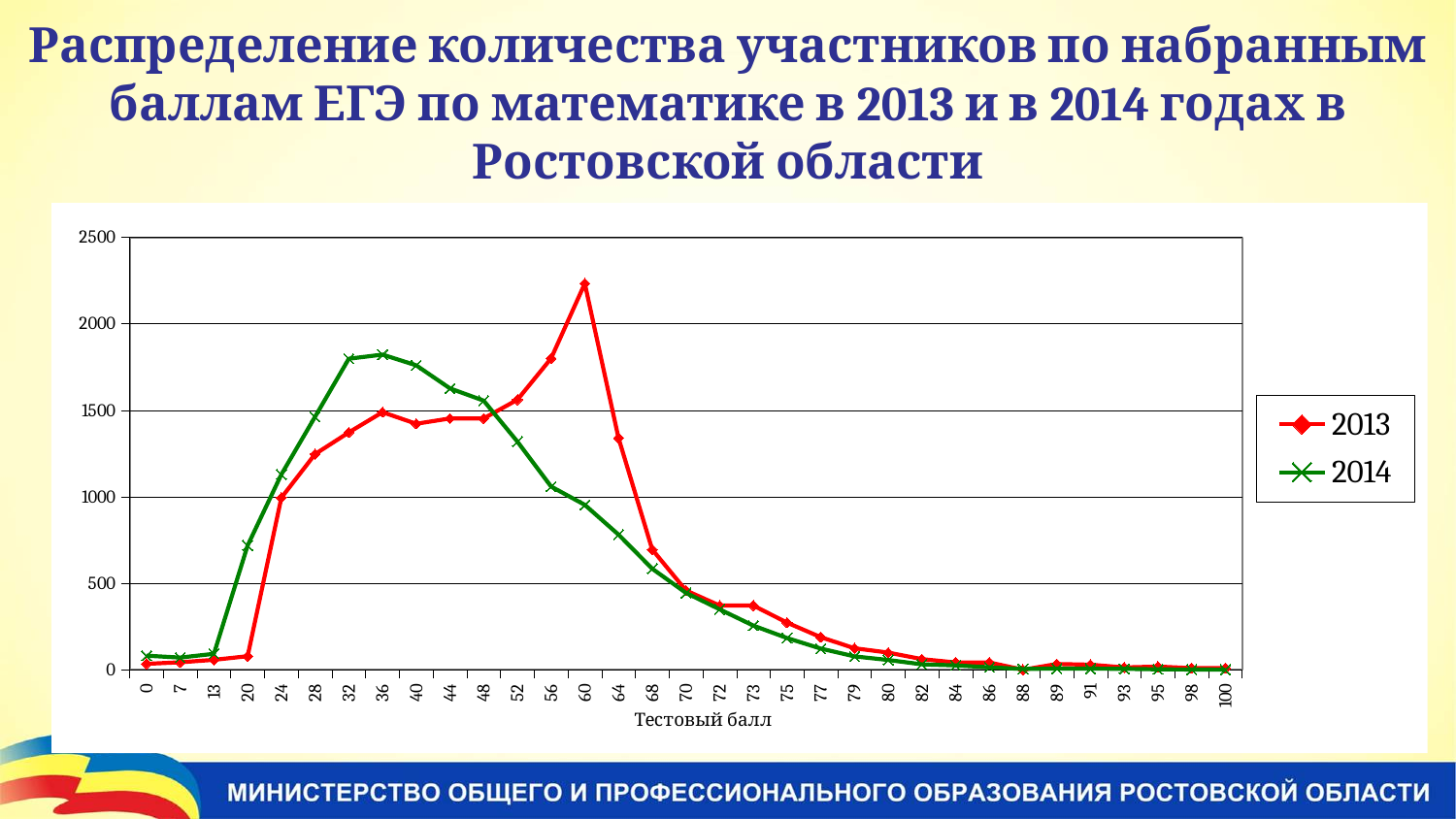
Is the value of the 2014 series at test score 36 greater or less than 1500? greater Which two series are listed in the legend? 2013 and 2014 How many series does the legend list? 2 Is the value of the 2014 series at test score 20 greater or less than 500? greater Is the value of the 2013 series at test score 60 greater or less than 2000? greater At test score 60, which series has the larger value, 2013 or 2014? 2013 What kind of chart is shown on the slide? line chart At test score 32, which series has the larger value, 2013 or 2014? 2014 At which test score does the 2013 series reach its highest value? 60 What is the label of the x axis? Тестовый балл Do the values of the 2013 series rise or fall from test score 60 to test score 100? fall